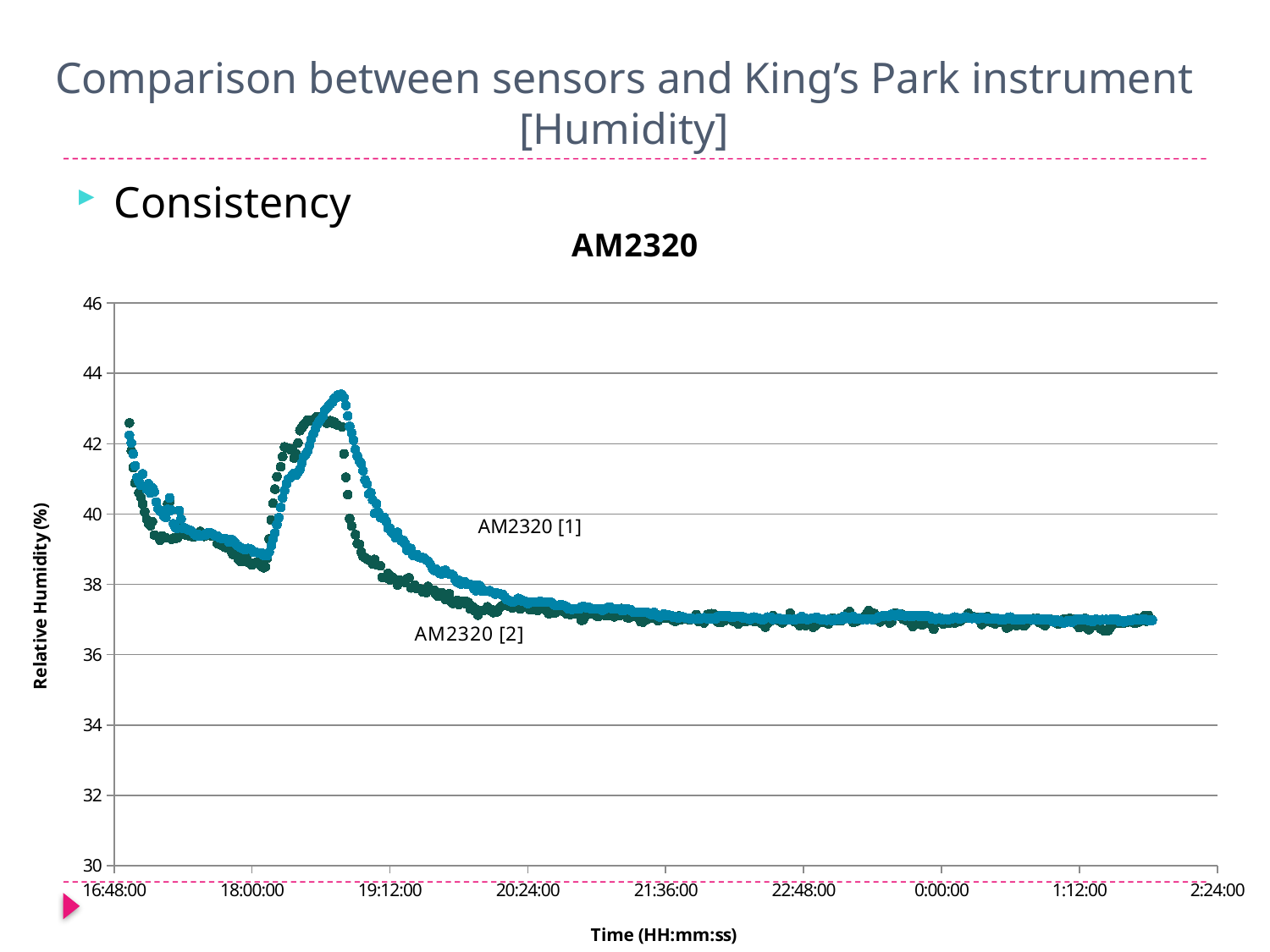
What is the lowest value shown on the y axis? 30 Is the value of AM2320 [2] at 0:00:00 greater or less than 38? less Which series reaches the higher peak relative humidity? AM2320 [1] Is the value of AM2320 [1] at 18:00:00 greater or less than 40? less What is the label of the y axis? Relative Humidity (%) Is the first value of AM2320 [2] at around 16:48:00 greater or less than 42? greater Do the relative humidity values rise or fall between 19:12:00 and 20:24:00? fall How many data series are plotted on the chart? 2 At 19:12:00, which series has the higher relative humidity, AM2320 [1] or AM2320 [2]? AM2320 [1] What is the title of the chart? AM2320 What kind of chart is shown on the slide? scatter chart